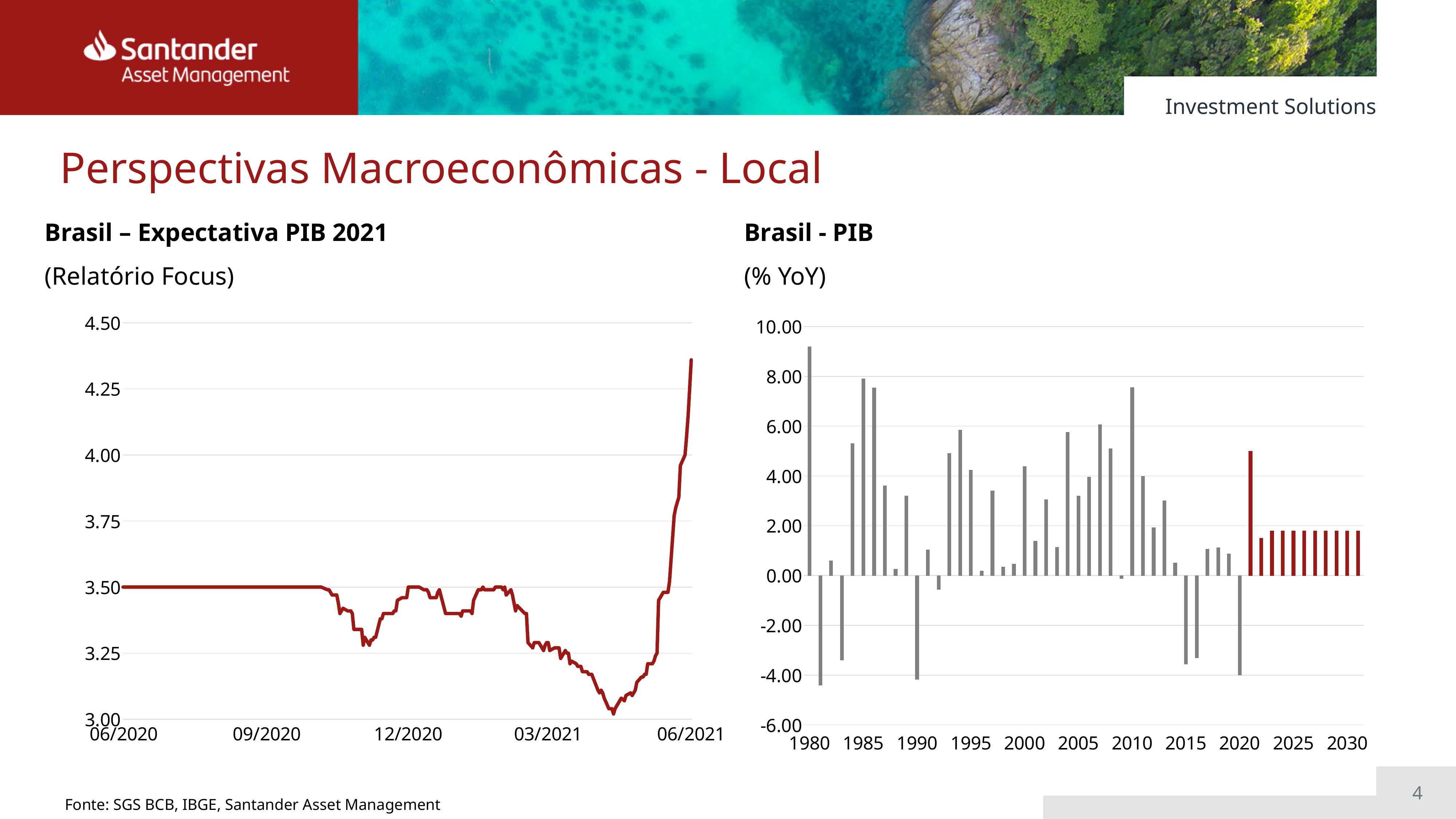
In the 'Brasil - PIB' chart, what colour are the bars for the years after 2020? red In the 'Brasil - PIB' chart, which bar is taller, 1980 or 2010? 1980 In the 'Brasil - PIB' chart, is the value for 2010 greater or less than 6.00? greater In the 'Brasil – Expectativa PIB 2021' chart, is the value at 06/2021 greater or less than 4.25? greater In the 'Brasil – Expectativa PIB 2021' chart, is the value at 03/2021 greater or less than 3.50? less What kind of chart is the 'Brasil – Expectativa PIB 2021' chart on the left? line chart What kind of chart is the 'Brasil - PIB' chart on the right? bar chart In the 'Brasil – Expectativa PIB 2021' chart, is the value at 06/2021 higher or lower than the value at 06/2020? higher In the 'Brasil - PIB' chart, which year has the highest bar? 1980